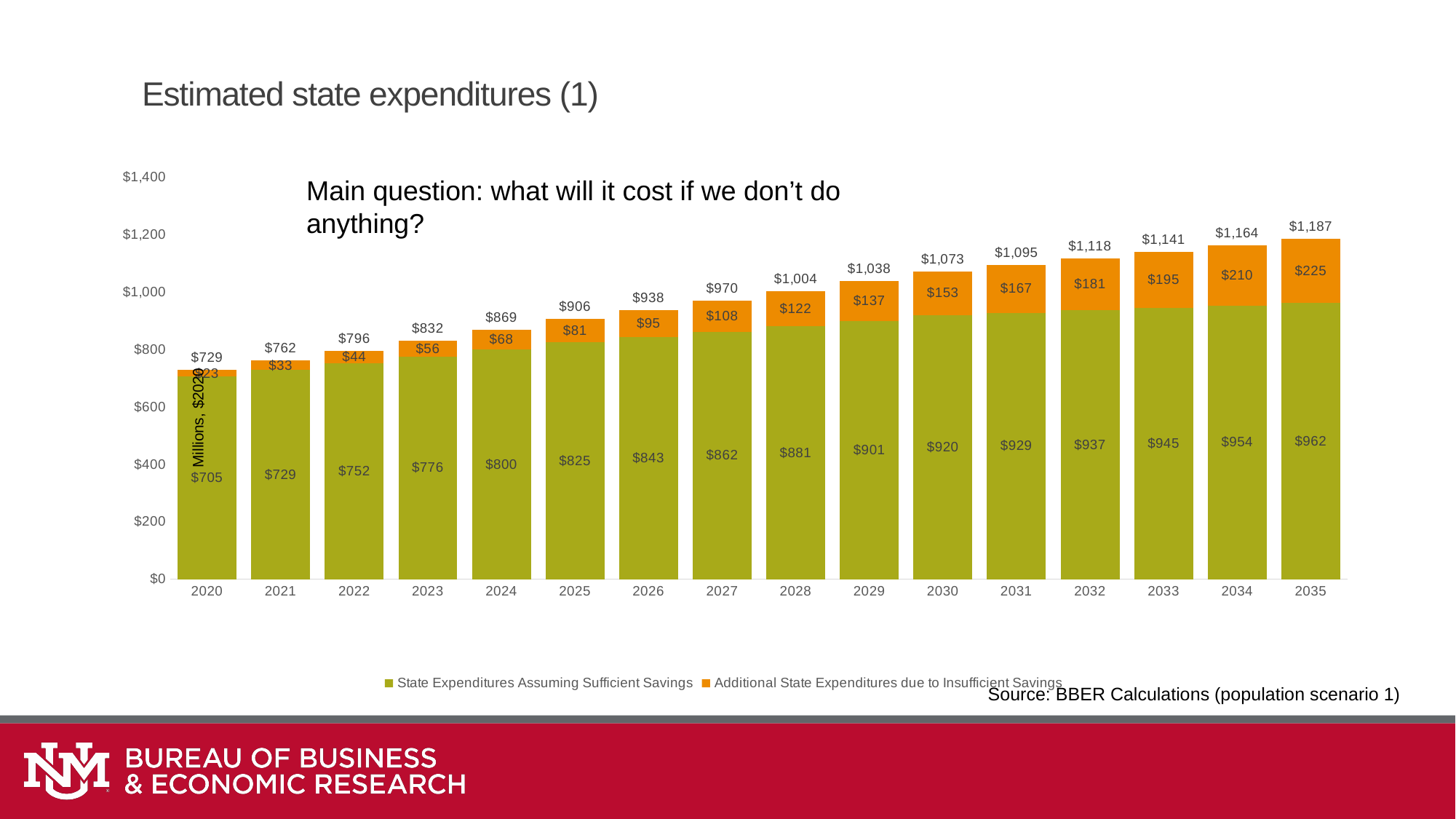
How many series does the legend list? 2 What kind of chart is shown on the slide? Stacked bar chart Which year has the lowest value for Additional State Expenditures due to Insufficient Savings? 2020 What is the difference between the Additional State Expenditures due to Insufficient Savings in 2035 and in 2021? $192 How many years are shown on the x axis? 16 Which year has the highest total state expenditures? 2035 What is the total labeled above the stacked bar for 2028? $1,004 What is the value of Additional State Expenditures due to Insufficient Savings for 2030? $153 Which is larger: State Expenditures Assuming Sufficient Savings in 2027 or in 2023? 2027 What is the value of State Expenditures Assuming Sufficient Savings for 2025? $825 Do the total state expenditures rise or fall from 2020 to 2035? Rise What is the total labeled above the stacked bar for 2035? $1,187